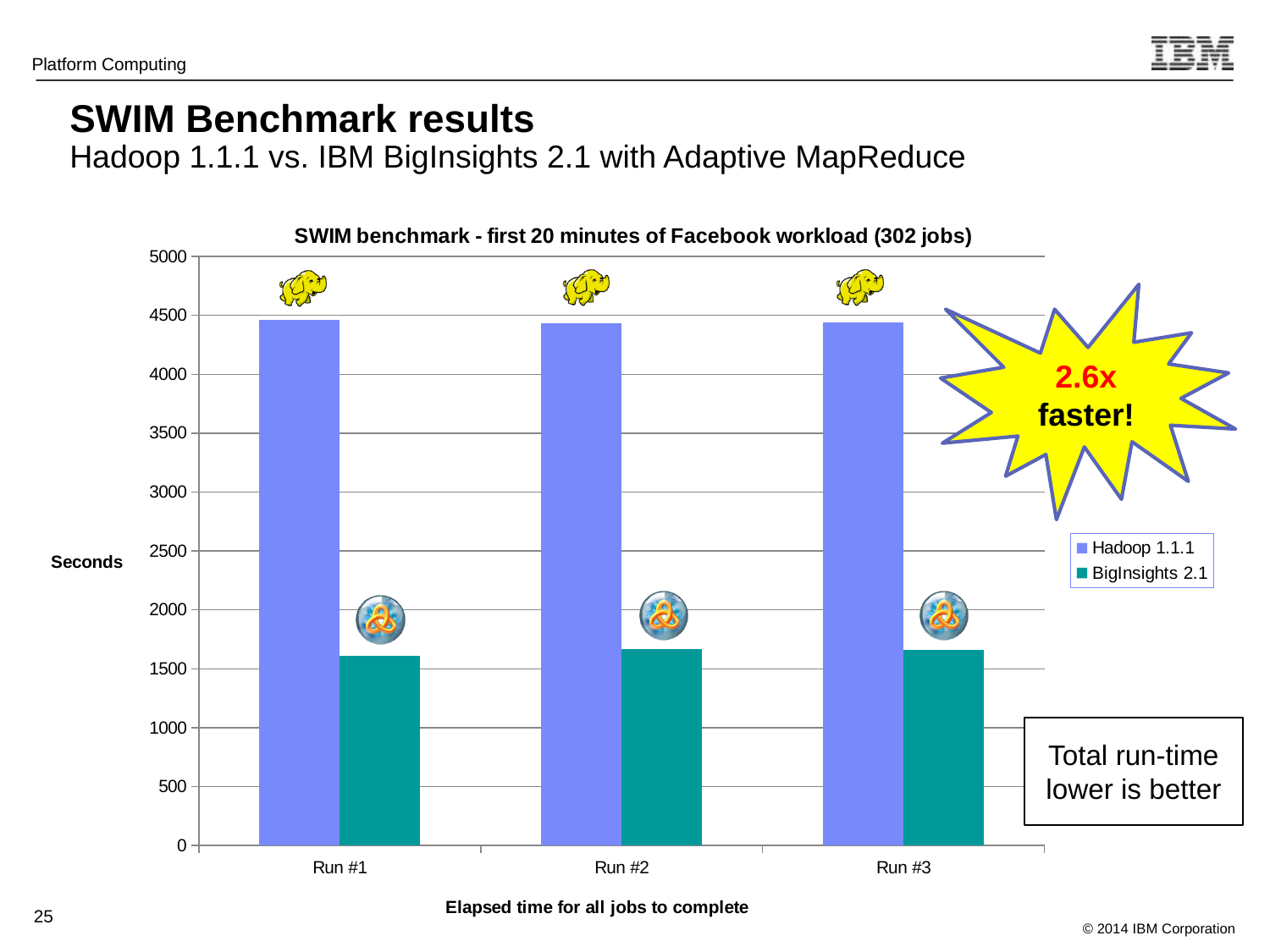
How many series does the legend list? 2 Is the value for BigInsights 2.1 in Run #1 greater or less than 2000? less Is the value for Hadoop 1.1.1 in Run #3 greater or less than 3000? greater Which two series are listed in the legend? Hadoop 1.1.1 and BigInsights 2.1 Is the value for Hadoop 1.1.1 in Run #2 greater or less than 4500? less What is the title of the chart? SWIM benchmark - first 20 minutes of Facebook workload (302 jobs) In Run #2, which series has the larger value, Hadoop 1.1.1 or BigInsights 2.1? Hadoop 1.1.1 What kind of chart is shown on the slide? bar chart How many runs (categories) are shown on the x axis? 3 In Run #3, which series has the smaller value, Hadoop 1.1.1 or BigInsights 2.1? BigInsights 2.1